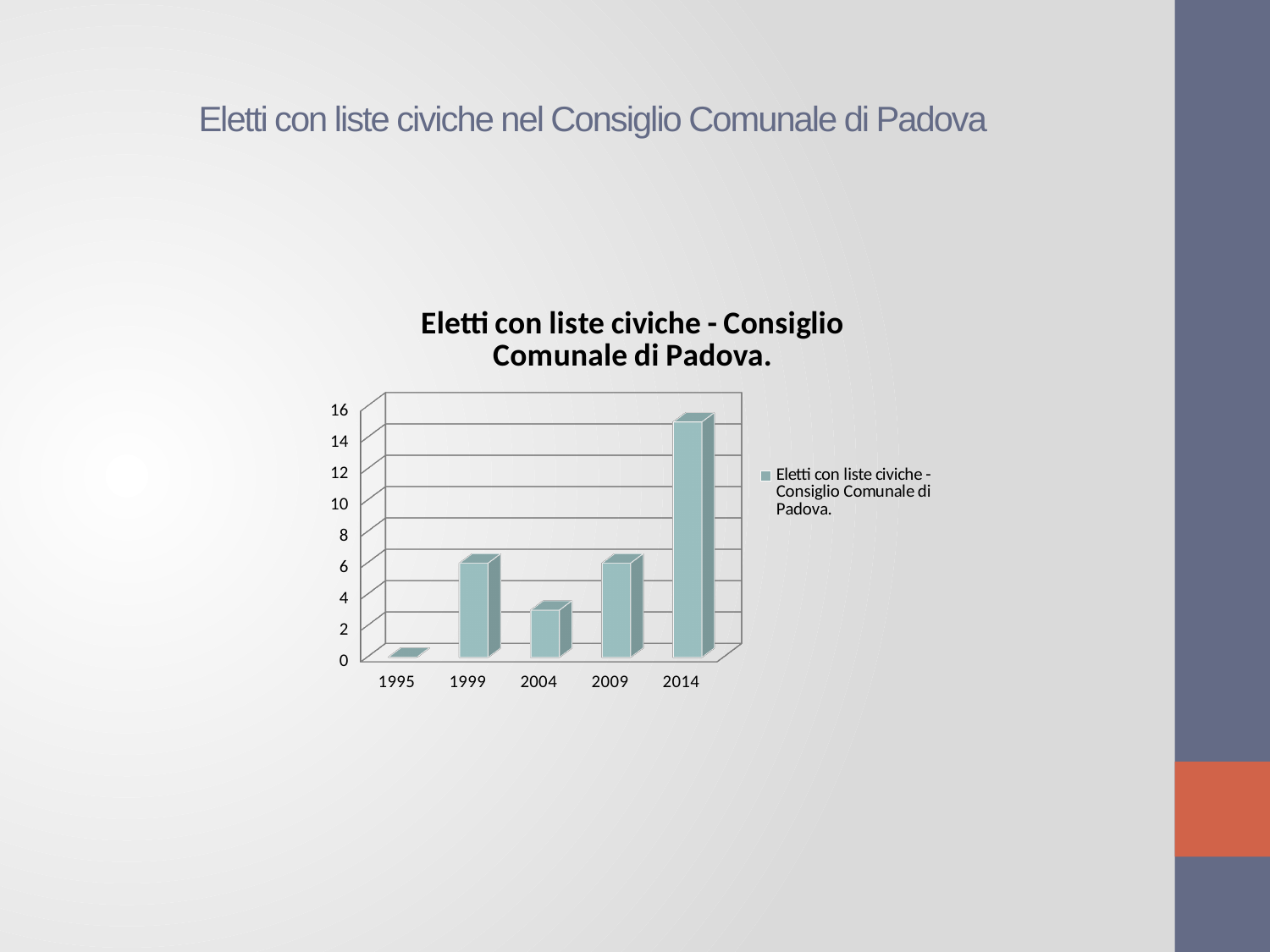
Is the value for 2004 greater or less than 4? less Is the value for 2014 greater or less than 12? greater What is the title of the chart? Eletti con liste civiche - Consiglio Comunale di Padova. What kind of chart is shown on the slide? bar chart Which year has the highest value in the chart? 2014 Is the value for 1995 greater or less than 2? less Which year has the lowest value in the chart? 1995 How many years are shown on the x axis of the chart? 5 Which is larger, the value for 2004 or the value for 2014? 2014 How many series does the chart's legend list? 1 Does the value rise or fall from 2009 to 2014? rise